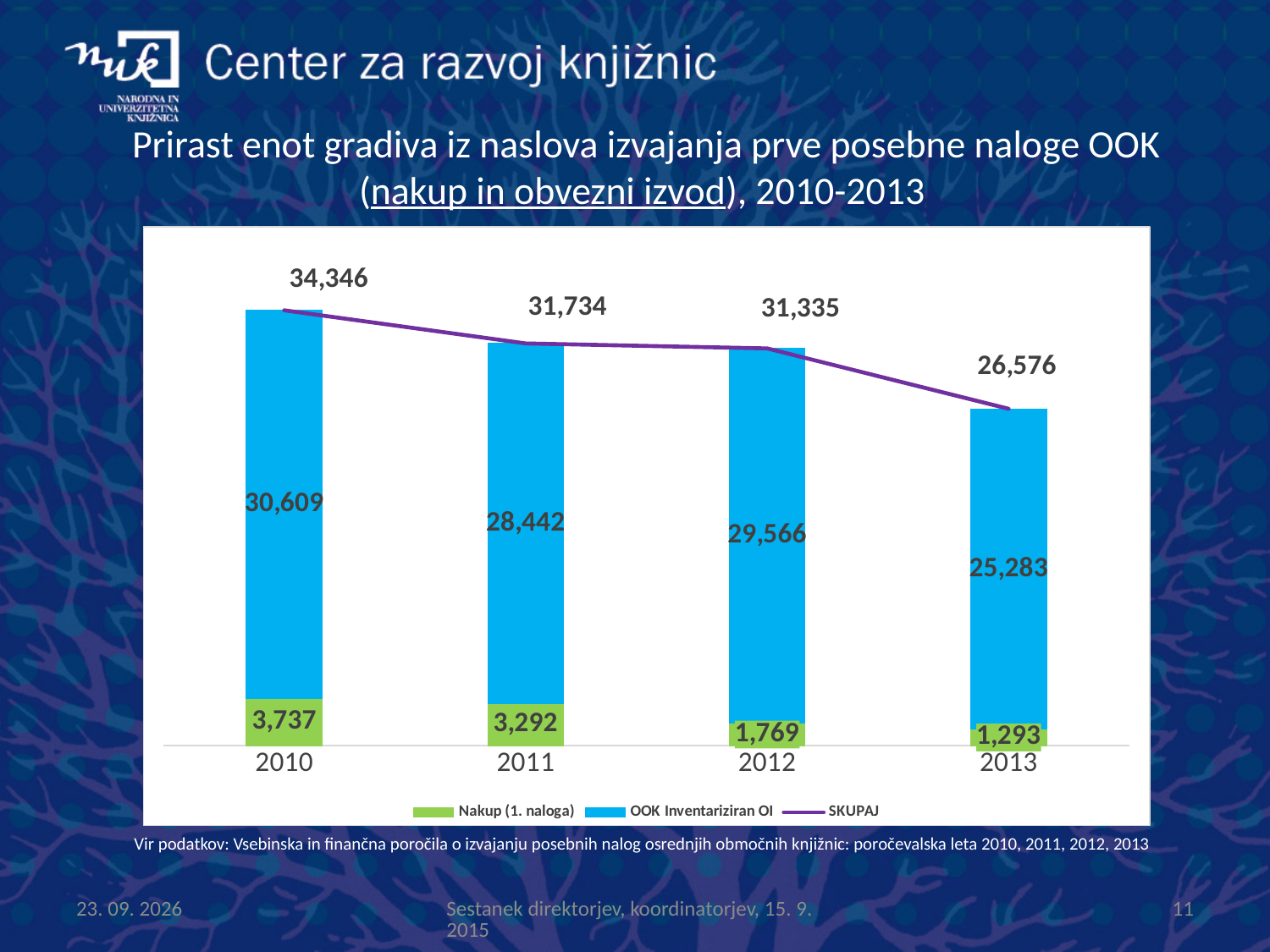
Which is larger, the OOK Inventariziran OI value for 2011 or for 2012? 2012 What is the value of OOK Inventariziran OI for 2013? 25,283 Does the SKUPAJ line rise or fall from 2010 to 2013? Fall What is the difference between the SKUPAJ values for 2010 and 2013? 7,770 What kind of chart is shown on the slide? Stacked bar chart with a line How many years are shown on the x axis? 4 What is the value of Nakup (1. naloga) for 2010? 3,737 Which year has the highest SKUPAJ value? 2010 How many series does the legend list? 3 Which year has the lowest value for Nakup (1. naloga)? 2013 What is the SKUPAJ value for 2011? 31,734 What is the total of the stacked bar for 2012? 31,335